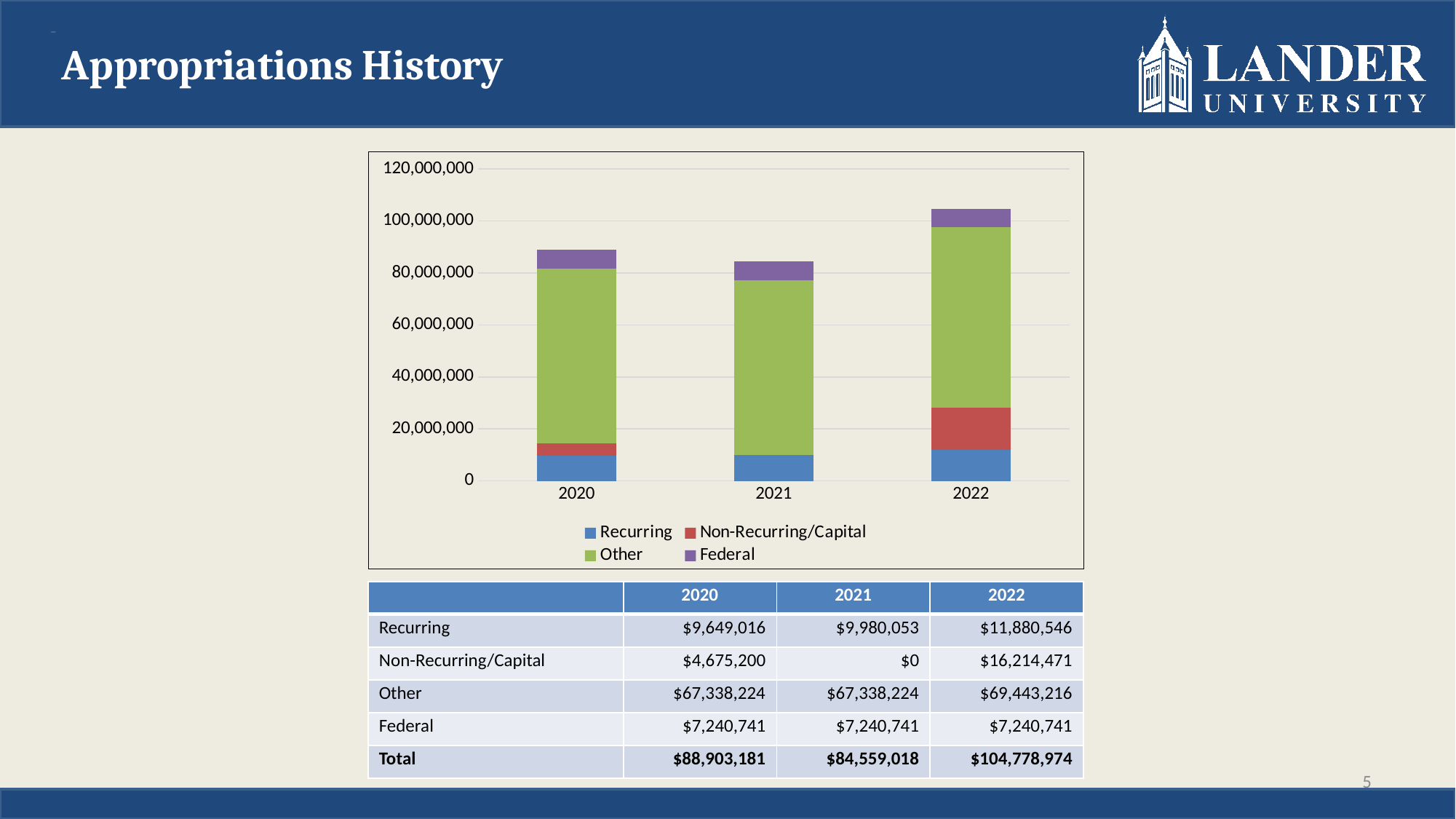
What is the Recurring value for 2022? $11,880,546 How many series does the chart legend list? 4 Is the total for 2022 greater or less than 100,000,000? greater What is the Federal value for 2020? $7,240,741 What is the total of the stacked bar for 2022? $104,778,974 Which colour represents the Other series in the chart? green What kind of chart is shown on the slide? stacked bar chart What is the Non-Recurring/Capital value for 2021? $0 How many years are shown on the x axis of the chart? 3 Which year has the lowest total appropriations? 2021 What is the difference between the Other value for 2022 and the Other value for 2021? $2,104,992 Which year has the highest total appropriations? 2022